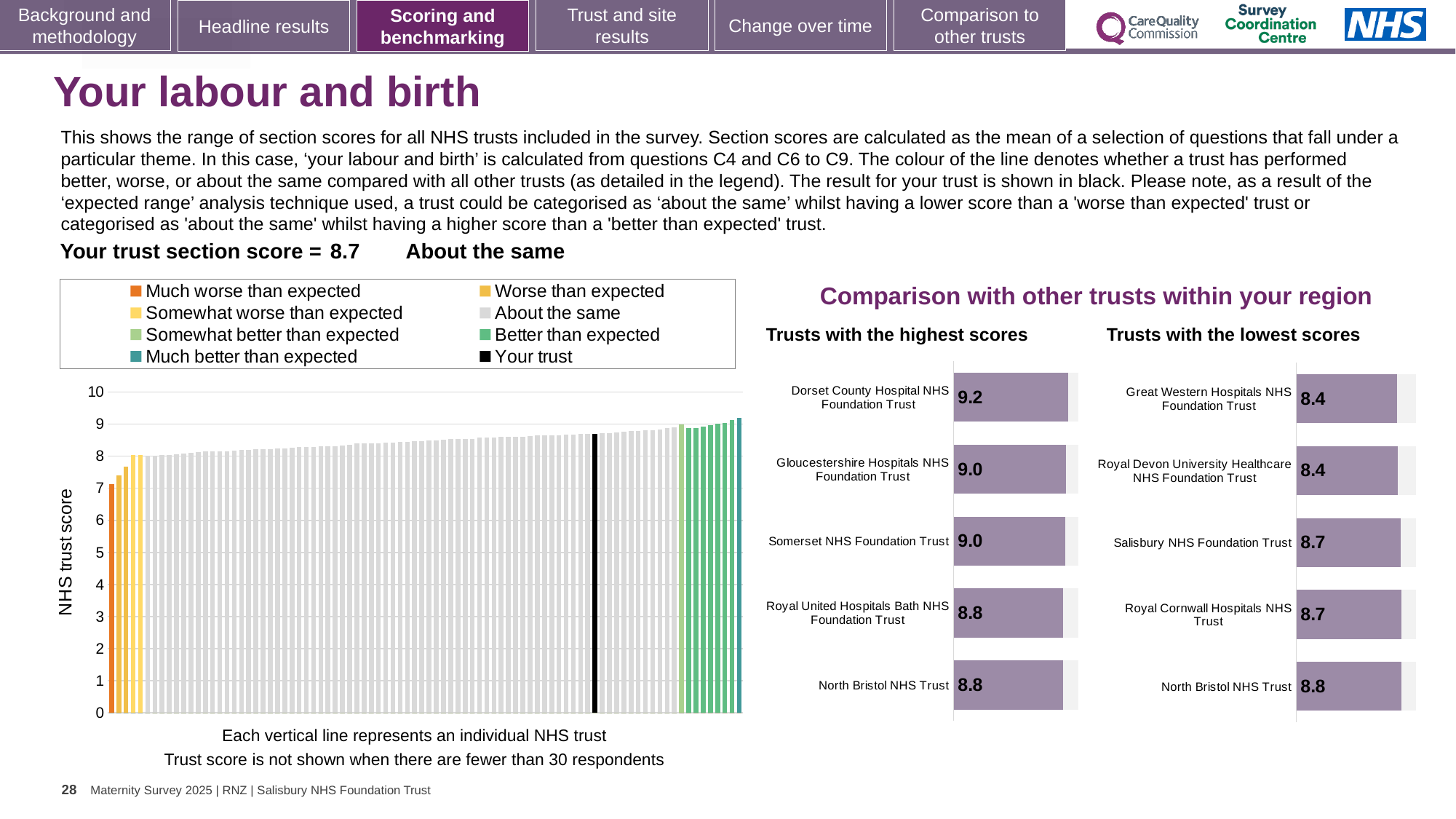
In the 'Trusts with the lowest scores' chart, which has the larger score: Salisbury NHS Foundation Trust or Great Western Hospitals NHS Foundation Trust? Salisbury NHS Foundation Trust In the 'Trusts with the highest scores' chart, what is the score for Dorset County Hospital NHS Foundation Trust? 9.2 In the 'Trusts with the lowest scores' chart, what is the score for Royal Cornwall Hospitals NHS Trust? 8.7 In the large 'NHS trust score' chart, do the bar values rise or fall from left to right? Rise In the 'Trusts with the lowest scores' chart, which trust has the highest score? North Bristol NHS Trust In the 'Trusts with the highest scores' chart, which trust has the highest score? Dorset County Hospital NHS Foundation Trust How many trusts are listed in the 'Trusts with the highest scores' chart? 5 In the large 'NHS trust score' chart, is the value of the leftmost bar greater or less than 8? less How many entries does the legend of the large 'NHS trust score' chart list? 8 In the 'Trusts with the highest scores' chart, what is the difference between the scores of Dorset County Hospital NHS Foundation Trust and North Bristol NHS Trust? 0.4 In the 'Trusts with the lowest scores' chart, what is the score for Great Western Hospitals NHS Foundation Trust? 8.4 What kind of chart is the large chart with the 'NHS trust score' axis? Bar chart